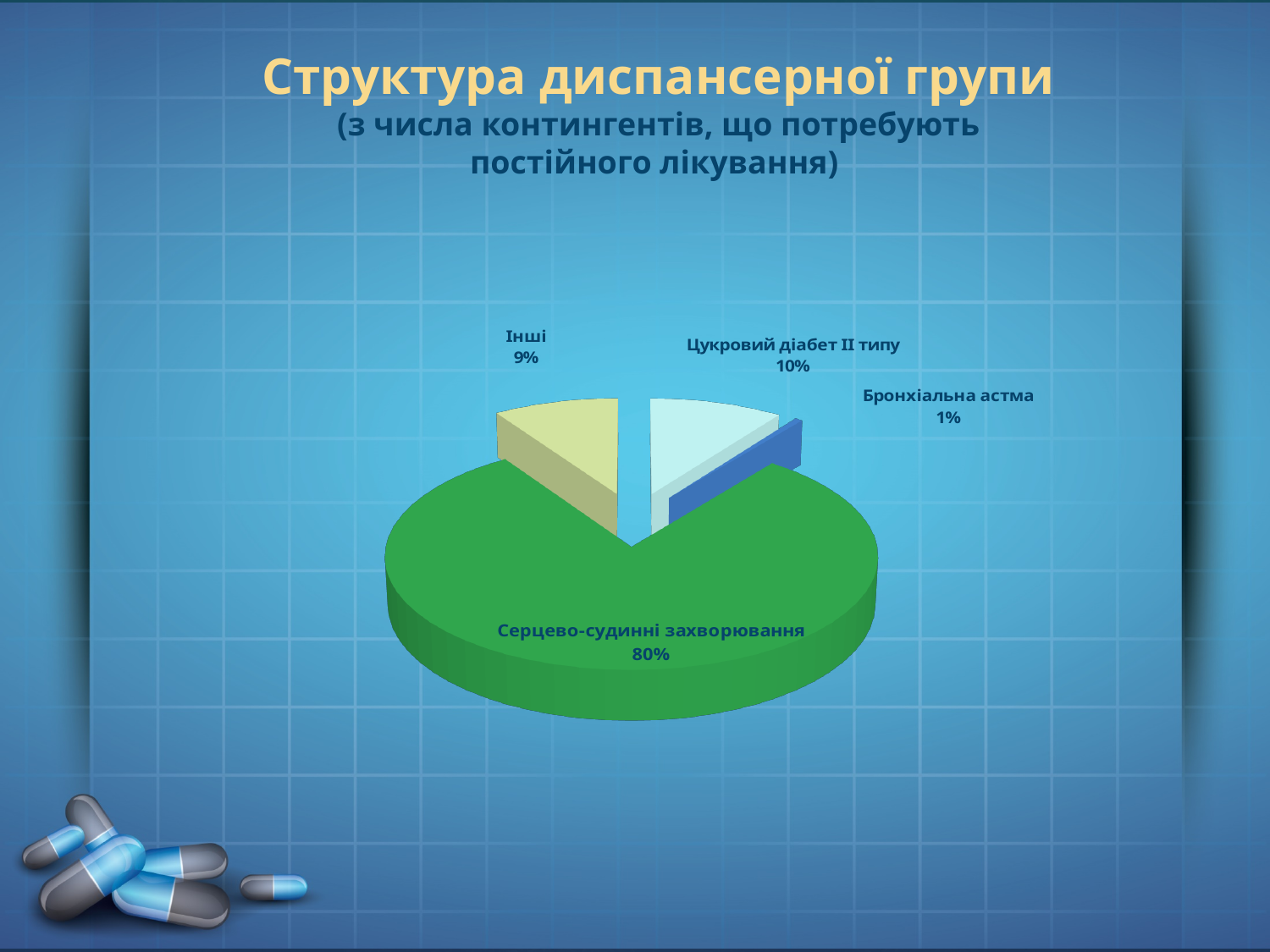
What share of the pie does Цукровий діабет II типу have? 10% Which category has the largest slice of the pie? Серцево-судинні захворювання Which category has the smallest slice of the pie? Бронхіальна астма What is the difference in percentage points between Серцево-судинні захворювання and Цукровий діабет II типу? 70 Which is larger, the share for Цукровий діабет II типу or the share for Інші? Цукровий діабет II типу What share of the pie does Серцево-судинні захворювання have? 80% What share of the pie does Інші have? 9% How many slices does the pie chart have? 4 What kind of chart is shown on the slide? pie chart What colour is the slice for Серцево-судинні захворювання? green What is the difference in percentage points between Інші and Бронхіальна астма? 8